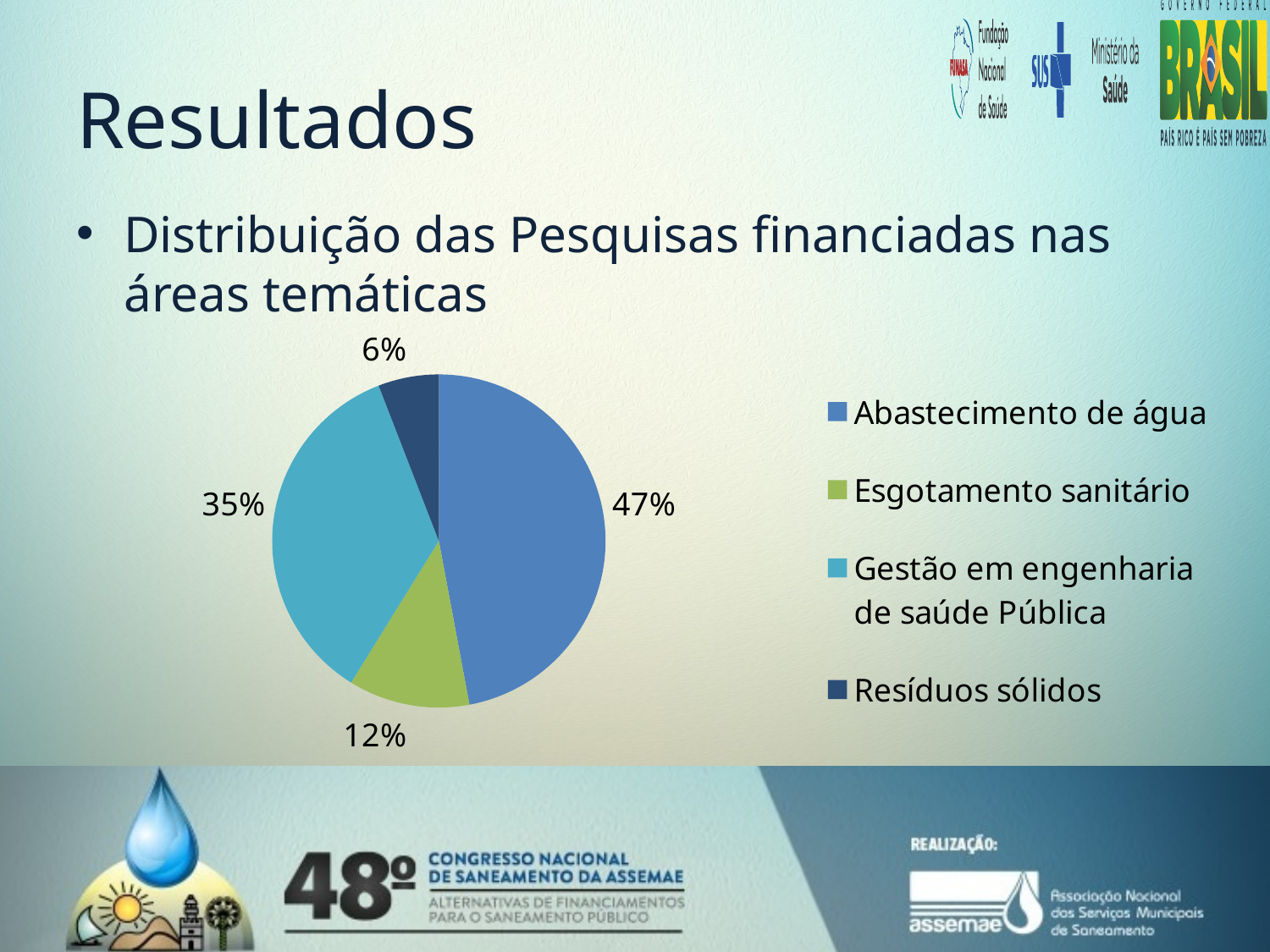
Which category has the largest slice of the pie? Abastecimento de água How many categories does the pie chart show? 4 What share of the pie does Resíduos sólidos have? 6% Which is larger, the share for Esgotamento sanitário or the share for Resíduos sólidos? Esgotamento sanitário What share of the pie does Gestão em engenharia de saúde Pública have? 35% What is the difference in percentage points between Abastecimento de água and Gestão em engenharia de saúde Pública? 12 What is the combined share of Esgotamento sanitário and Resíduos sólidos? 18% What share of the pie does Esgotamento sanitário have? 12% Which category is shown in green in the legend? Esgotamento sanitário What kind of chart is shown on the slide? Pie chart Which category has the smallest slice of the pie? Resíduos sólidos